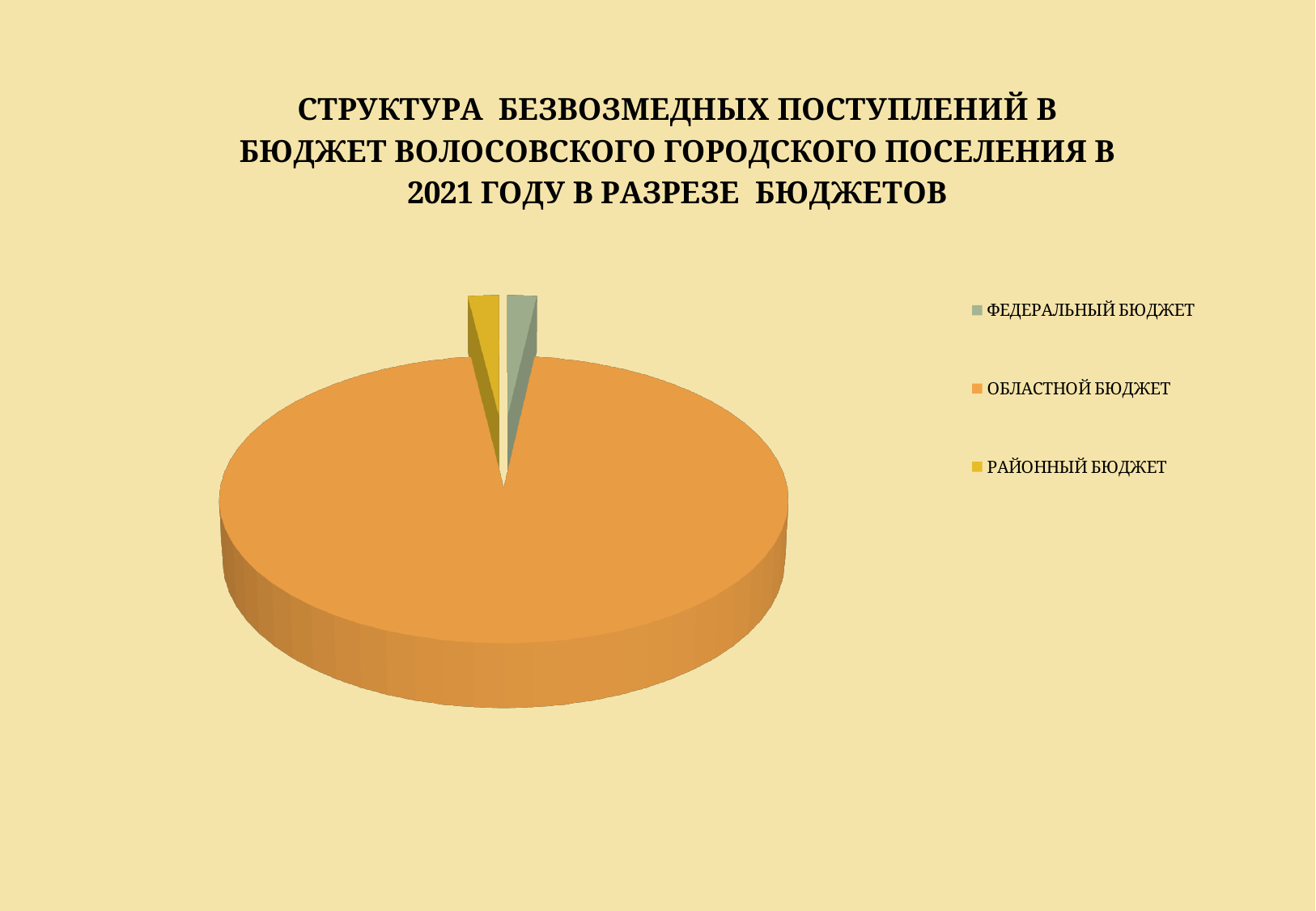
What kind of chart is shown on the slide? Pie chart How many entries does the legend list? 3 How many slices does the pie chart have? 3 Which is larger: the slice for РАЙОННЫЙ БЮДЖЕТ or the slice for ОБЛАСТНОЙ БЮДЖЕТ? ОБЛАСТНОЙ БЮДЖЕТ Which legend entry is shown in orange? ОБЛАСТНОЙ БЮДЖЕТ Which year does the chart title refer to? 2021 Which budget accounts for the largest share of the pie? ОБЛАСТНОЙ БЮДЖЕТ Which is larger: the slice for ОБЛАСТНОЙ БЮДЖЕТ or the slice for ФЕДЕРАЛЬНЫЙ БЮДЖЕТ? ОБЛАСТНОЙ БЮДЖЕТ